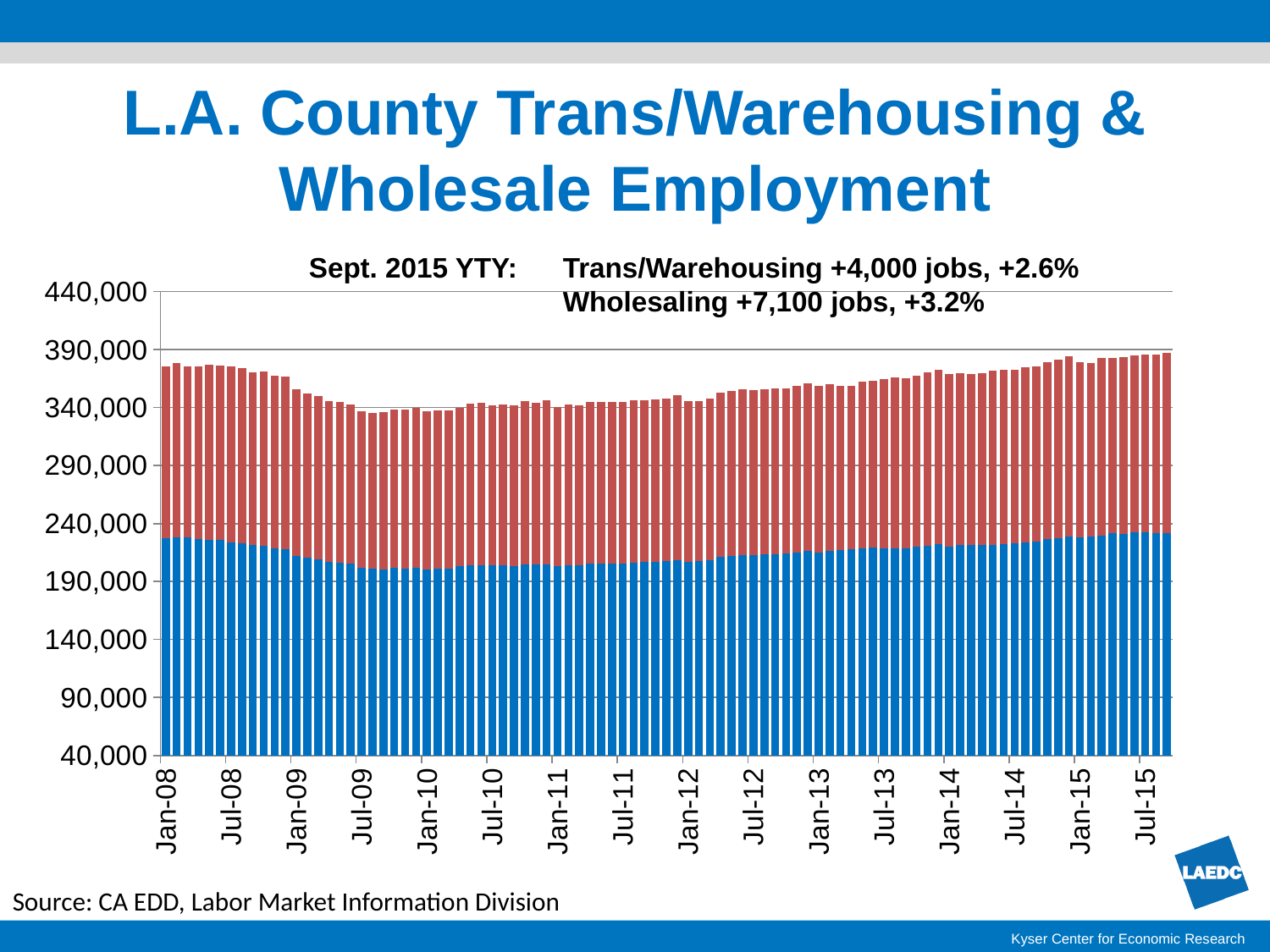
Is the blue (bottom) segment for Jul-15 greater or less than 240,000? less Do the total bar heights rise or fall from Jan-10 to Jul-15? rise Is the total height of the stacked bar for Jan-08 greater or less than 390,000? less Which has the taller stacked bar, Jan-08 or Jul-09? Jan-08 Is the total height of the stacked bar for Jan-13 greater or less than 340,000? greater What kind of chart is shown on the slide? stacked bar chart Which has the taller stacked bar, Jan-10 or Jul-15? Jul-15 According to the annotation on the chart, how many jobs did Trans/Warehousing add year-to-year as of Sept. 2015? +4,000 jobs How many series are stacked in each bar of the chart? 2 Do the total bar heights rise or fall from Jan-08 to Jul-09? fall